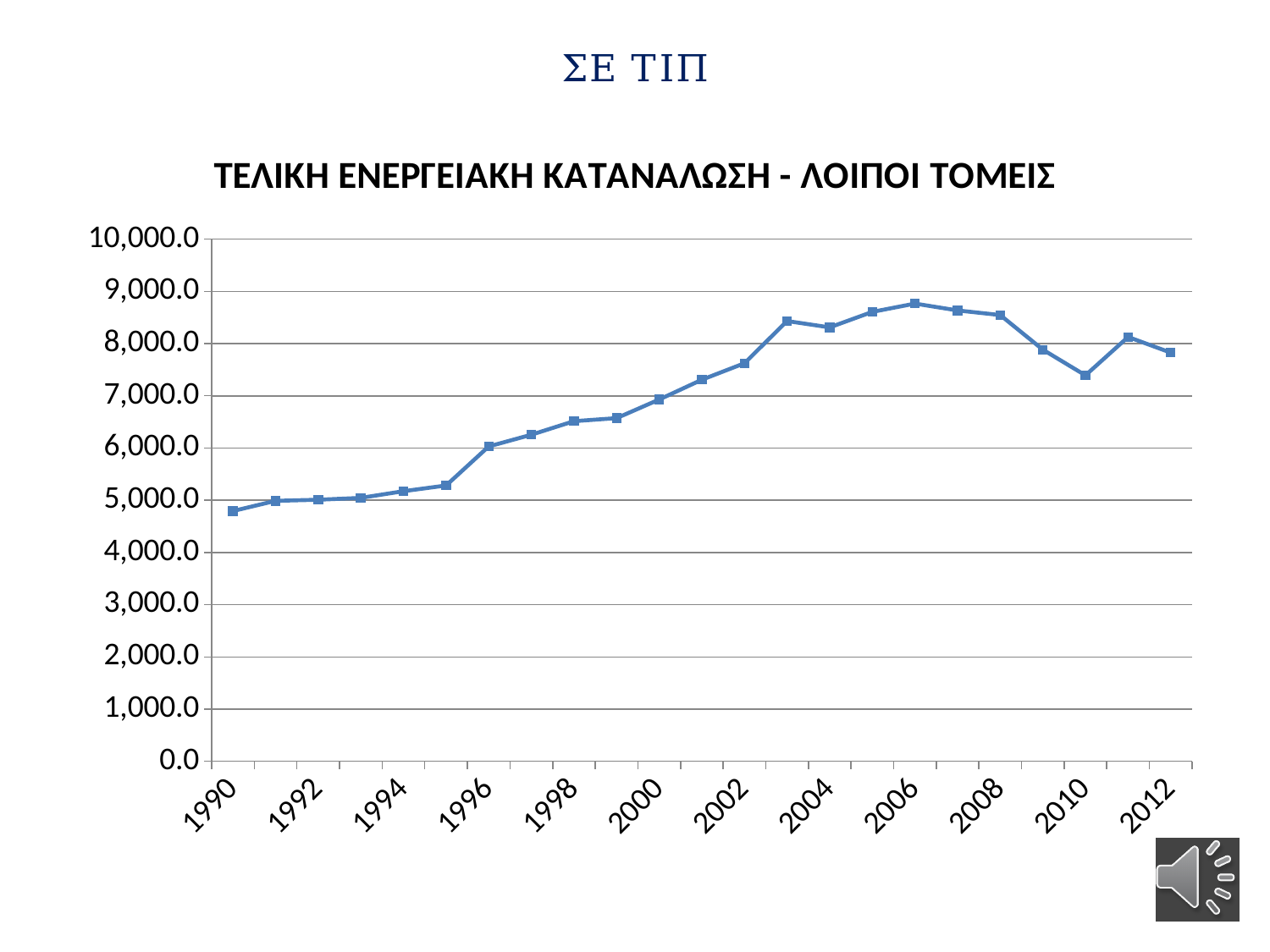
Which year has the larger value, 1990 or 2012? 2012 What is the title of the chart? ΤΕΛΙΚΗ ΕΝΕΡΓΕΙΑΚΗ ΚΑΤΑΝΑΛΩΣΗ - ΛΟΙΠΟΙ ΤΟΜΕΙΣ Which year has the larger value, 2006 or 2010? 2006 Is the value for 2002 greater or less than 7,000.0? greater How many data points are plotted on the line (years 1990 through 2012)? 23 What kind of chart is shown on the slide? line chart Is the value for 2006 greater or less than 8,000.0? greater Is the value for 1990 greater or less than 5,000.0? less In which year does the line have its lowest value? 1990 Does the line generally rise or fall from 1990 to 2006? rise In which year does the line reach its highest value? 2006